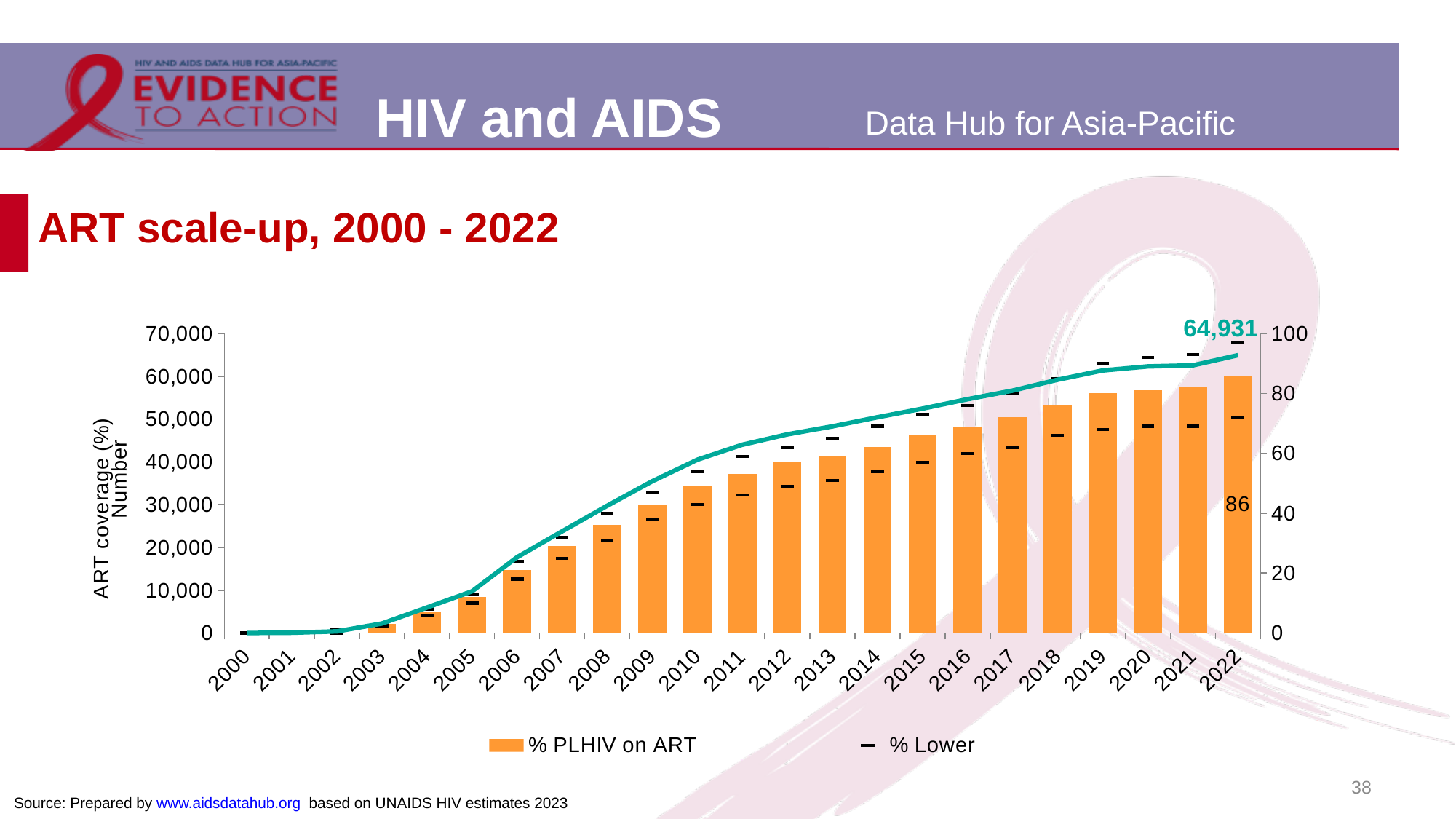
Is the % PLHIV on ART bar for 2010 greater or less than 40? greater Which year has the highest % PLHIV on ART bar? 2022 Do the % PLHIV on ART bars generally rise or fall from 2000 to 2022? rise Is the line value for 2010 greater or less than 30,000? greater What is the title of the chart? ART scale-up, 2000 - 2022 What is the % PLHIV on ART value labelled for 2022? 86 What are the two entries listed in the legend? % PLHIV on ART and % Lower What number is labelled on the line for 2022? 64,931 Which year has the larger % PLHIV on ART bar, 2010 or 2015? 2015 How many years are shown on the x axis? 23 How many series does the legend list? 2 Is the % PLHIV on ART bar for 2005 greater or less than 20? less